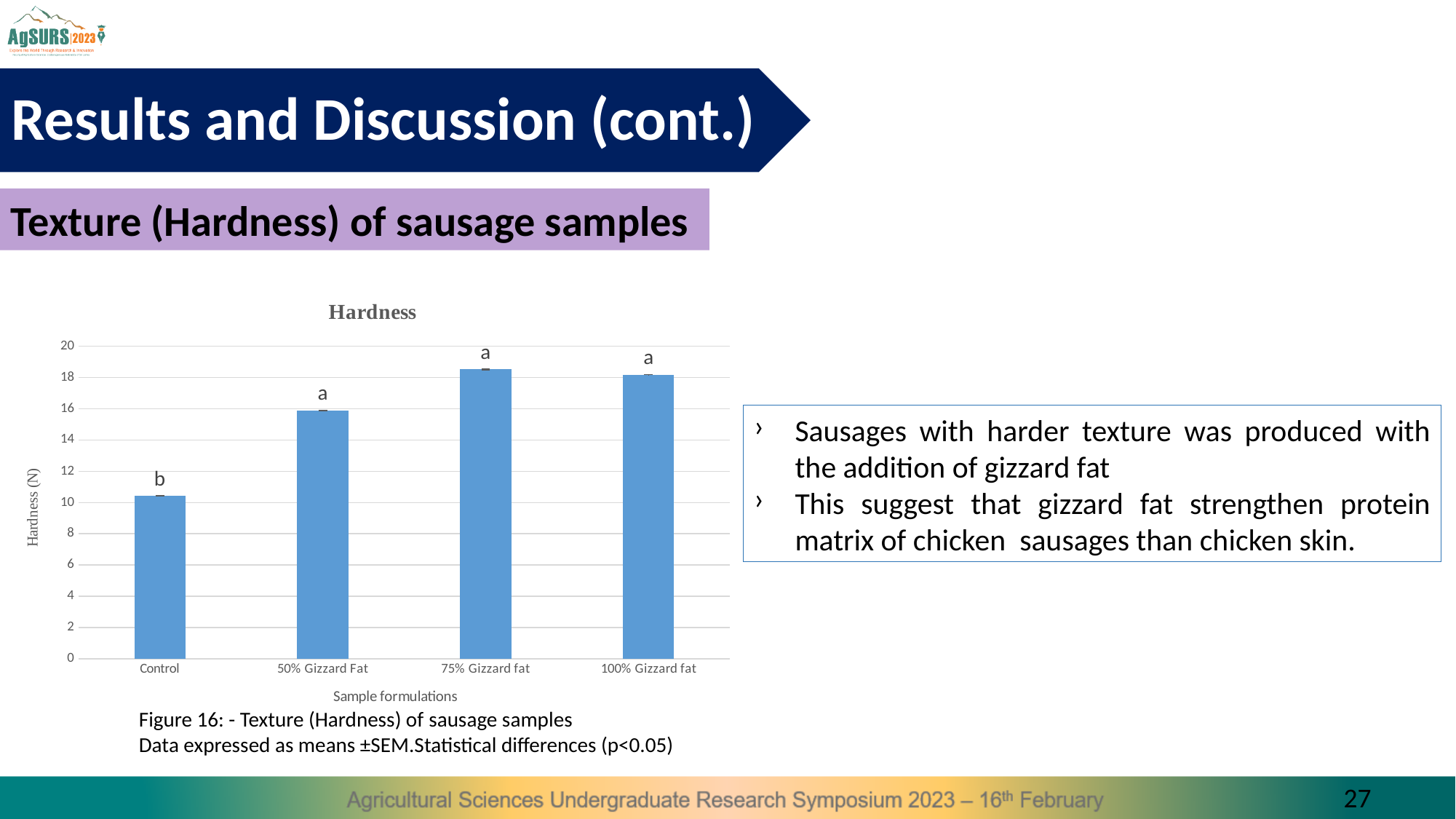
What kind of chart is shown on the slide? bar chart What letter is printed above the Control bar in the chart? b Is the hardness value for 50% Gizzard Fat greater or less than 14? greater Do the hardness values rise or fall from Control to 75% Gizzard fat? rise Which sample formulation has the highest hardness in the chart? 75% Gizzard fat Is the hardness value for Control greater or less than 12? less Which sample formulation has the lowest hardness in the chart? Control Is the hardness value for 75% Gizzard fat greater or less than 18? greater How many sample formulations are plotted in the Hardness chart? 4 What is the title of the vertical axis in the chart? Hardness (N) Which has a higher hardness value, Control or 50% Gizzard Fat? 50% Gizzard Fat